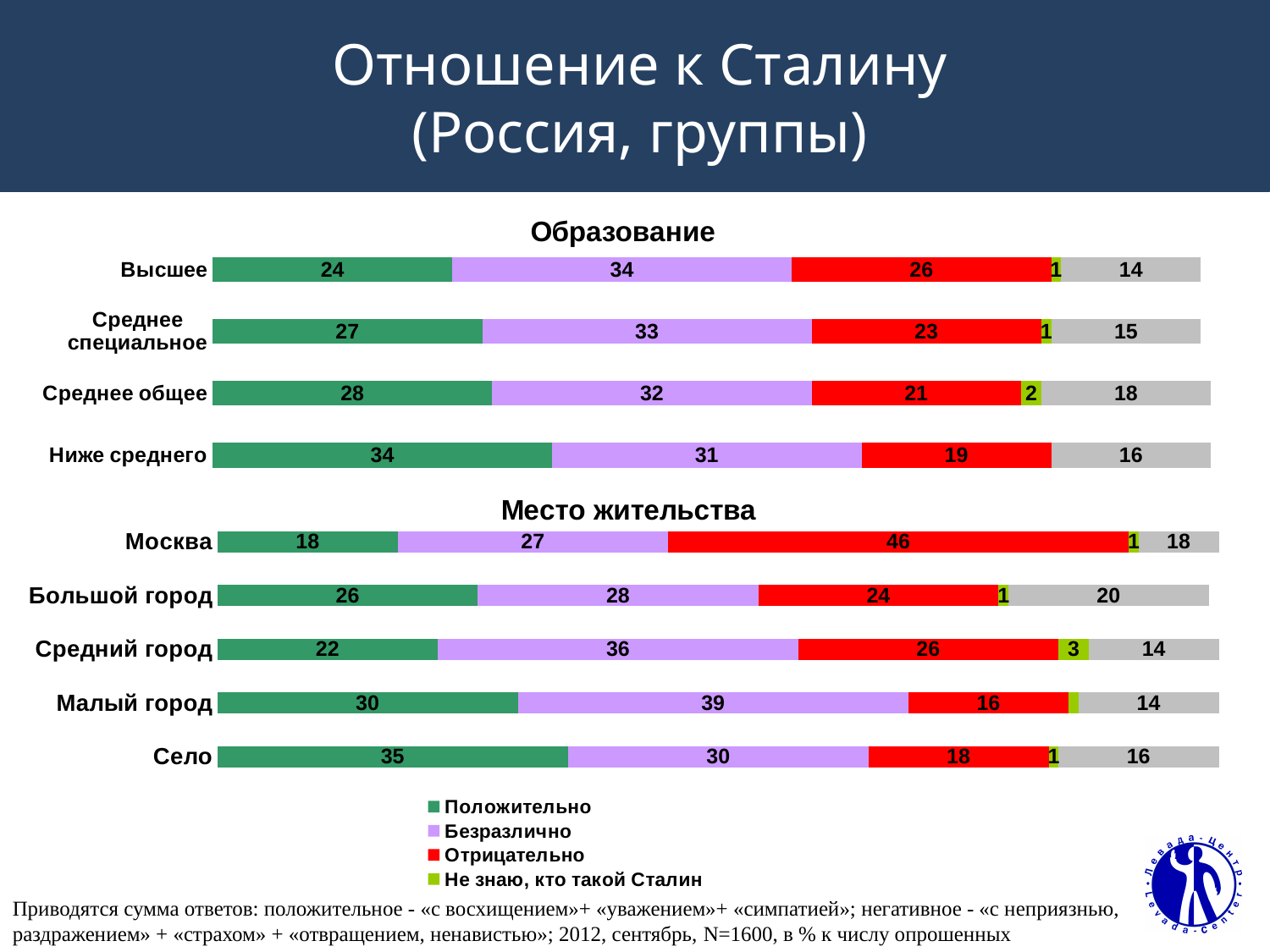
In the "Образование" chart, which is larger: the "Безразлично" value for "Высшее" or for "Ниже среднего"? Высшее In the "Образование" chart, which category has the highest "Положительно" value? Ниже среднего In the "Место жительства" chart, which category has the lowest "Положительно" value? Москва How many categories are shown in the "Место жительства" chart? 5 How many categories are shown in the "Образование" chart? 4 In the "Место жительства" chart, what is the value of "Отрицательно" for "Москва"? 46 In the "Образование" chart, what is the value of "Положительно" for "Высшее"? 24 How many series does the legend list? 4 In the "Образование" chart, what is the total of the labelled segments for "Высшее"? 99 In the "Место жительства" chart, what is the value of "Безразлично" for "Малый город"? 39 What kind of chart is the "Образование" chart? Stacked bar chart In the "Место жительства" chart, what is the difference between the "Отрицательно" values for "Москва" and "Село"? 28